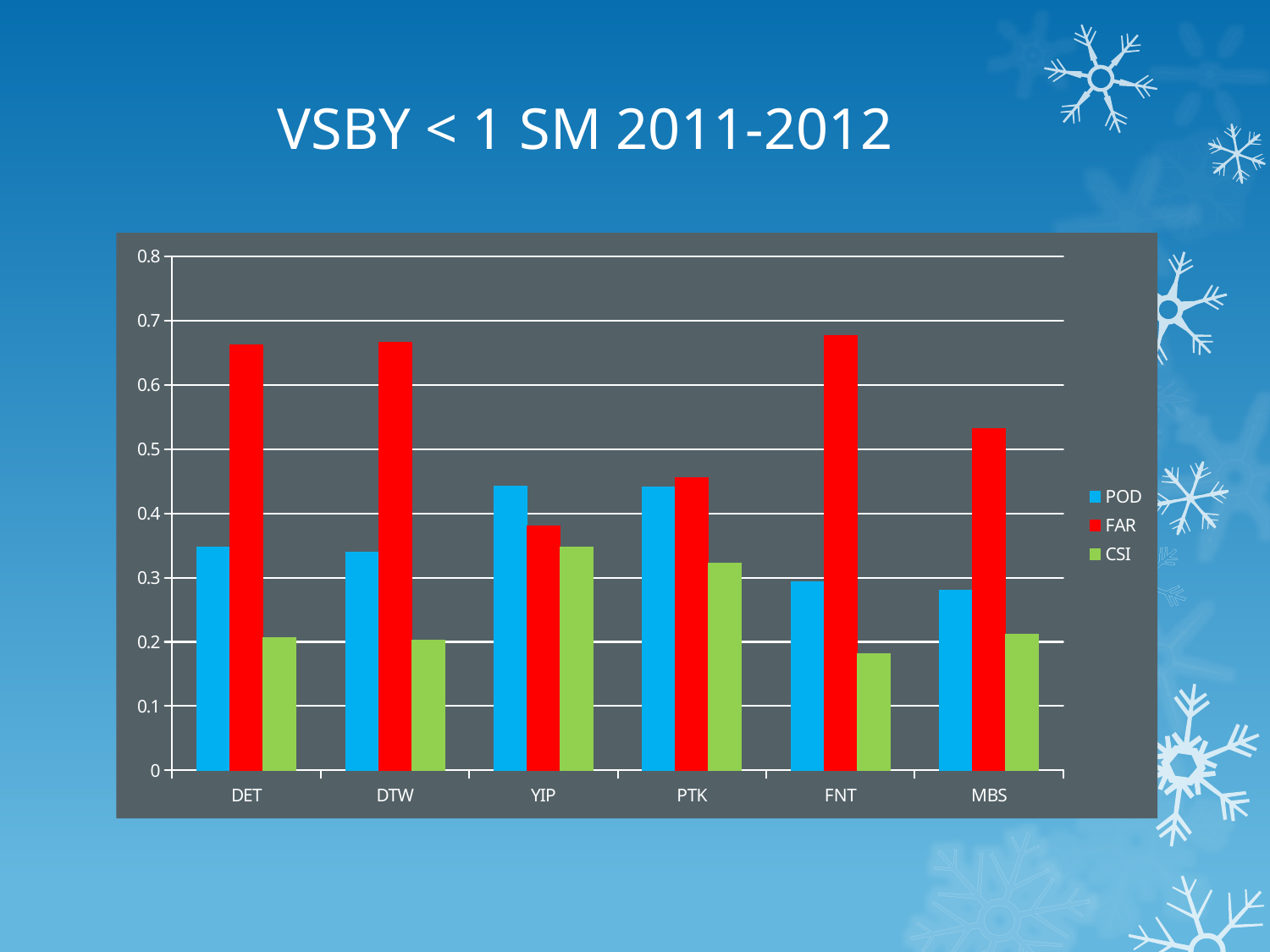
Which category has the lowest FAR value? YIP Is the CSI value for FNT greater or less than 0.2? less Is the FAR value for FNT greater or less than 0.6? greater What is the title of the chart? VSBY < 1 SM 2011-2012 How many categories are shown on the x axis? 6 How many series does the legend list? 3 Is the FAR value for MBS greater or less than 0.5? greater Which category has the lowest CSI value? FNT What type of chart is shown on the slide? bar chart At YIP, which is larger, POD or FAR? POD At DET, which is larger, POD or FAR? FAR Which category has the highest CSI value? YIP